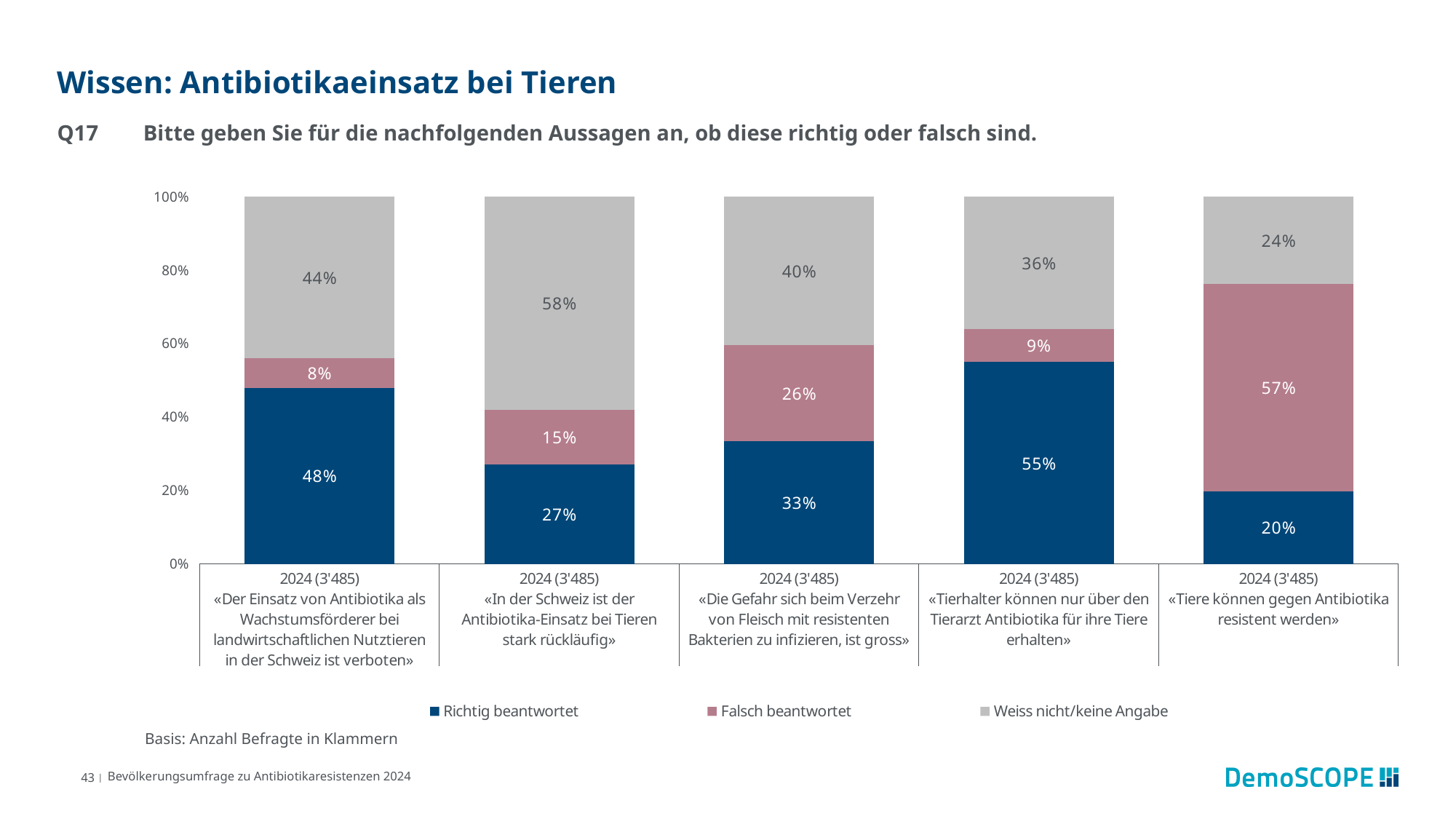
What kind of chart is shown on the slide? Stacked bar chart How many statements (bars) are shown in the chart? 5 How many series does the legend list? 3 What is the difference between the 'Richtig beantwortet' values for «Der Einsatz von Antibiotika als Wachstumsförderer ... ist verboten» and «In der Schweiz ist der Antibiotika-Einsatz bei Tieren stark rückläufig»? 21 percentage points Which is larger: the 'Falsch beantwortet' value for «Tierhalter können nur über den Tierarzt Antibiotika für ihre Tiere erhalten» or for «Der Einsatz von Antibiotika als Wachstumsförderer ... ist verboten»? «Tierhalter können nur über den Tierarzt Antibiotika für ihre Tiere erhalten» Which colour represents 'Richtig beantwortet' in the chart? Dark blue What is the 'Weiss nicht/keine Angabe' value for the statement «In der Schweiz ist der Antibiotika-Einsatz bei Tieren stark rückläufig»? 58% Which statement has the highest 'Richtig beantwortet' share? «Tierhalter können nur über den Tierarzt Antibiotika für ihre Tiere erhalten» What is the 'Falsch beantwortet' value for the statement «Die Gefahr sich beim Verzehr von Fleisch mit resistenten Bakterien zu infizieren, ist gross»? 26% What is the number of respondents shown in parentheses for each statement? 3'485 What share answered correctly (Richtig beantwortet) for the statement «Tiere können gegen Antibiotika resistent werden»? 20% Which statement has the lowest 'Weiss nicht/keine Angabe' share? «Tiere können gegen Antibiotika resistent werden»